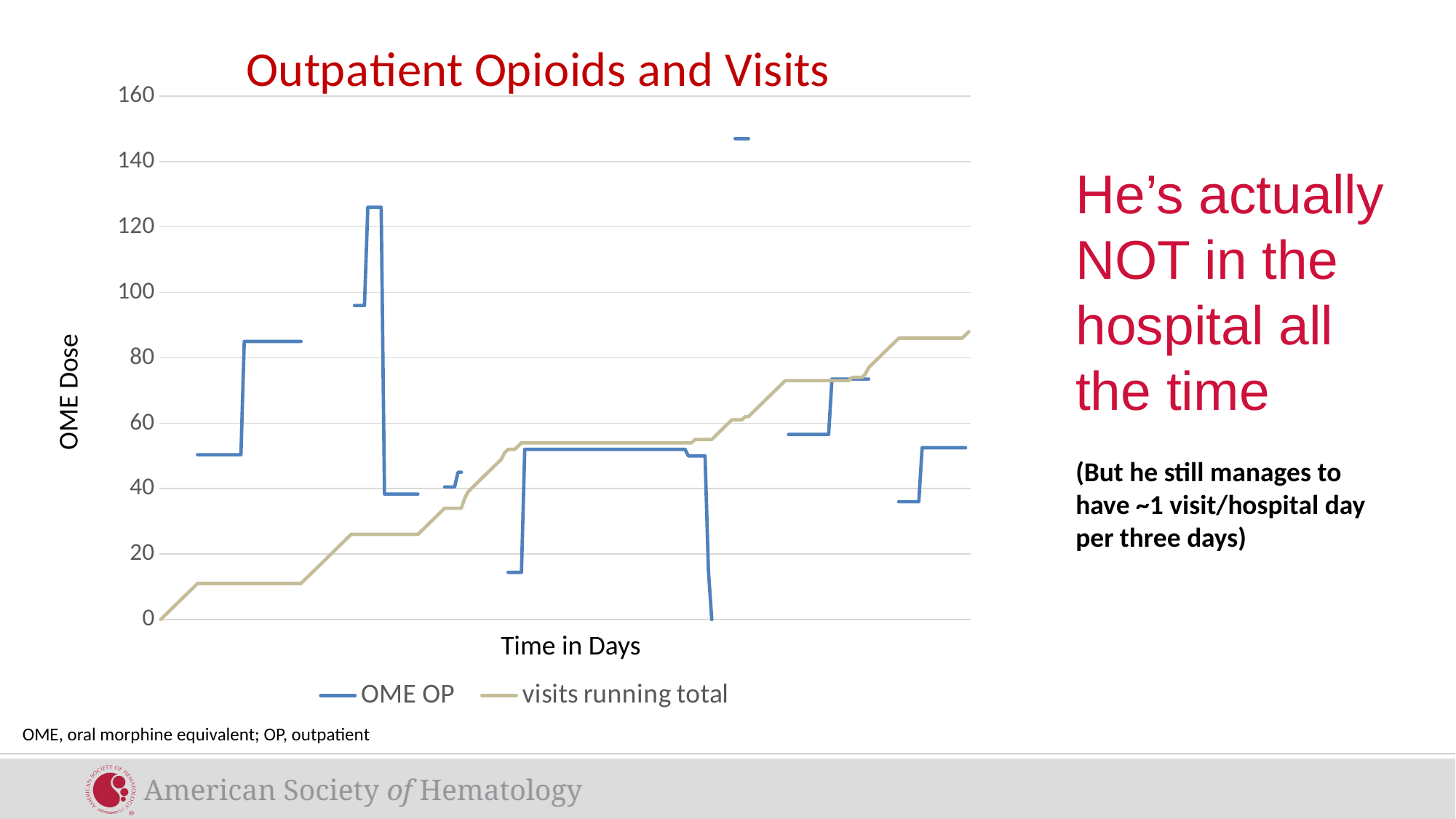
What is the lowest value the OME OP series reaches? 0 What is the title of the chart? Outpatient Opioids and Visits Is the final value of the visits running total series greater or less than 80? greater Which series reaches the higher maximum value, OME OP or visits running total? OME OP What kind of chart is shown on the slide? line chart How many series does the legend list? 2 What value does the visits running total series start at? 0 At the right end of the chart, which series has the higher value, OME OP or visits running total? visits running total Does the visits running total series rise or fall along the x axis? rise Is the highest point of the OME OP series greater or less than 140? greater What are the two series named in the legend? OME OP and visits running total Is the initial value of the OME OP series greater or less than 60? less